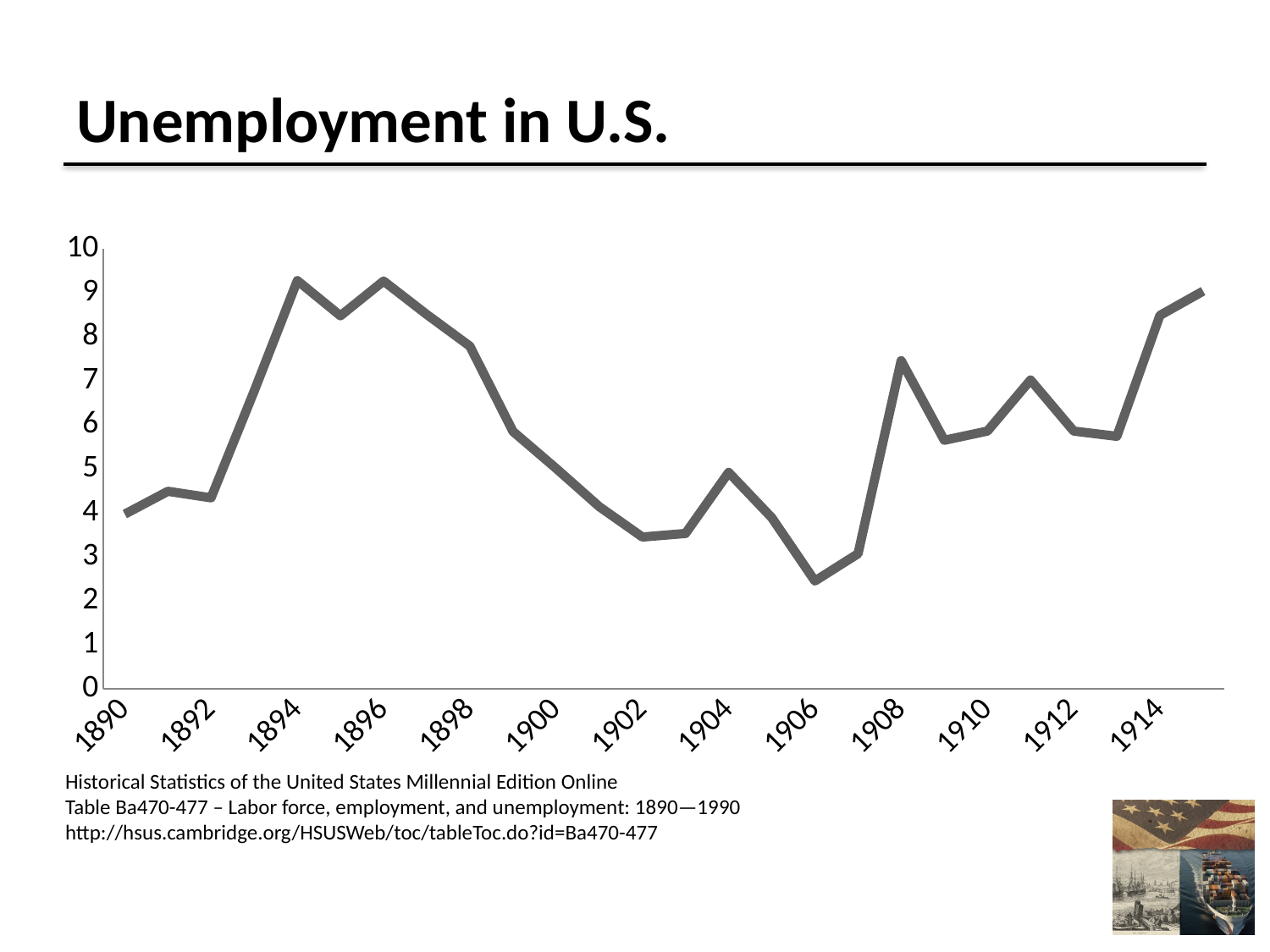
Is the value for 1902 greater or less than 4? less Which year has the lowest unemployment value on the chart? 1906 Is the value for 1890 greater or less than 5? less Which year has the larger value, 1906 or 1908? 1908 Is the value for 1906 greater or less than 3? less Do the values rise or fall between 1896 and 1902? fall What is the title of the chart? Unemployment in U.S. What kind of chart is shown on the slide? line chart How many year labels are shown on the x axis? 13